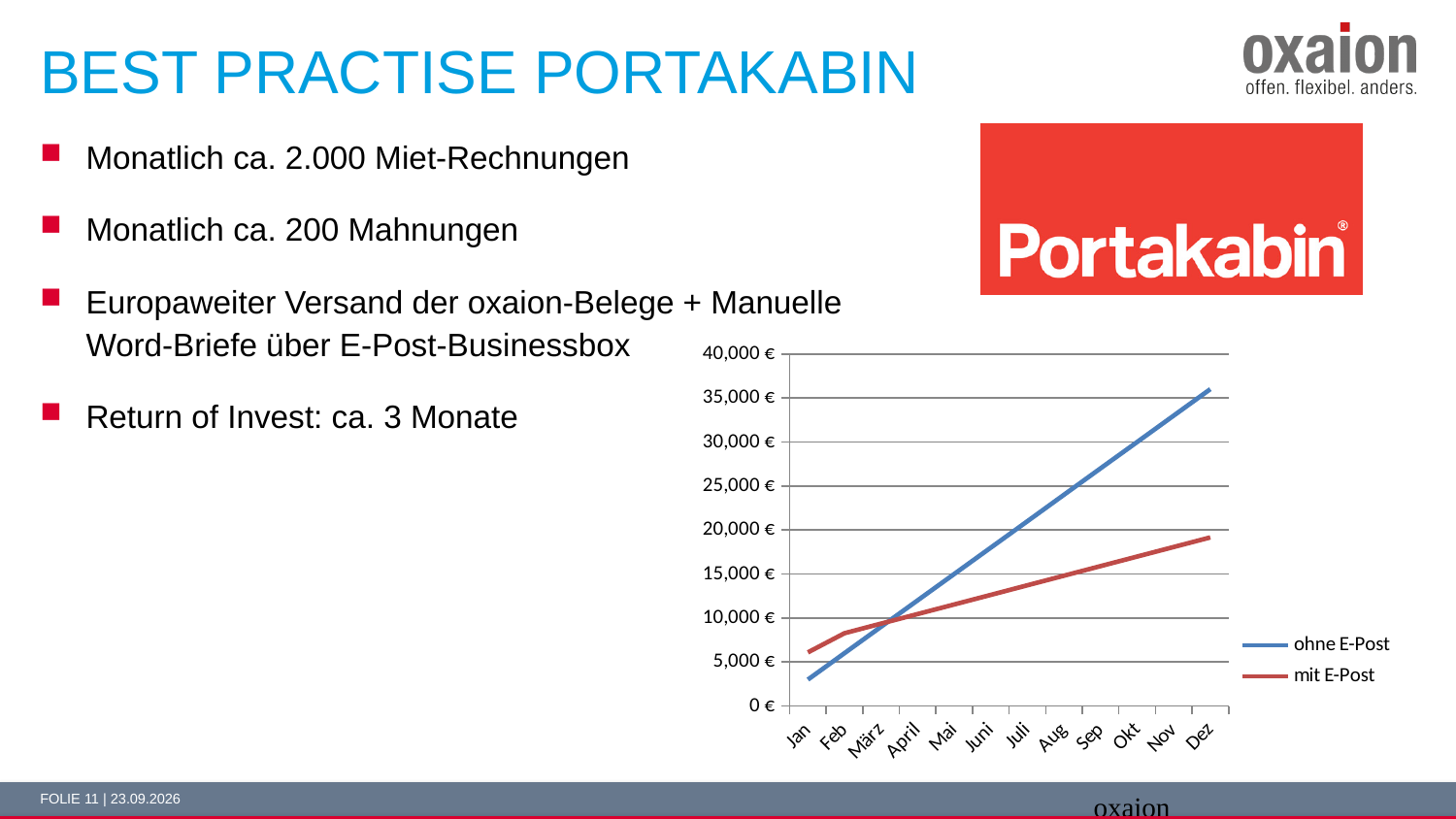
How many series does the chart legend list? 2 In Dez, which series has the larger value, 'ohne E-Post' or 'mit E-Post'? ohne E-Post Does the value for 'mit E-Post' rise or fall from Jan to Dez? rise What colour is the line for 'mit E-Post' in the chart? red How many months are shown on the x axis of the chart? 12 Is the value for 'mit E-Post' in Dez greater or less than 20,000 €? less What kind of chart is shown on the slide? line chart Is the value for 'mit E-Post' in Jan greater or less than 5,000 €? greater In Jan, which series has the larger value, 'ohne E-Post' or 'mit E-Post'? mit E-Post Does the value for 'ohne E-Post' rise or fall from Jan to Dez? rise Is the value for 'ohne E-Post' in Dez greater or less than 30,000 €? greater